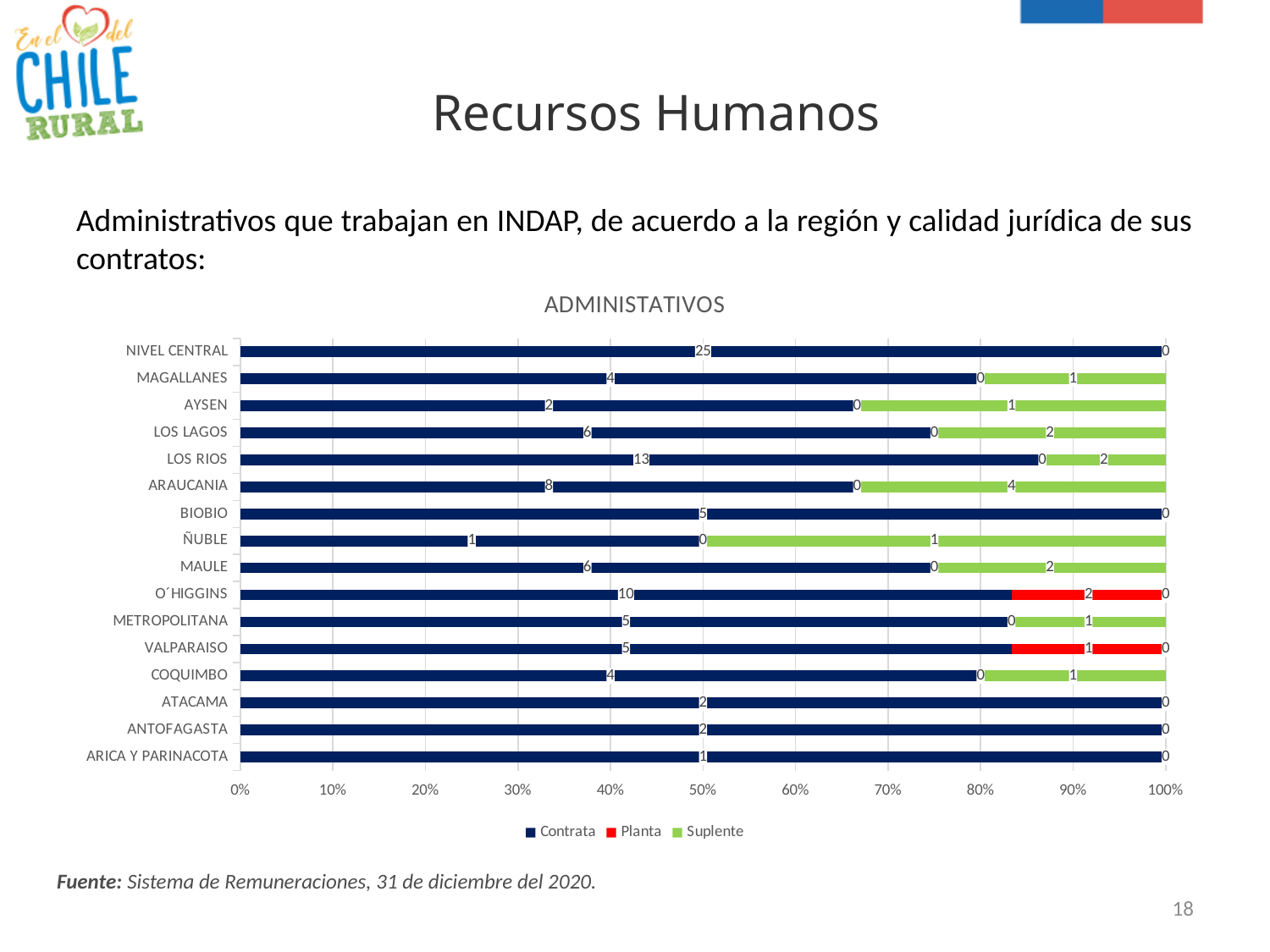
What is the Contrata value for LOS RIOS? 13 Which region has the highest Contrata value? NIVEL CENTRAL What is the total of the three series for O´HIGGINS? 12 What colour represents the Planta series in the legend? Red What is the Suplente value for ARAUCANIA? 4 How many regions (categories) are shown on the chart? 16 What is the Contrata value for NIVEL CENTRAL? 25 Which has the larger Contrata value, MAULE or COQUIMBO? MAULE What is the difference between the Contrata values for LOS RIOS and ARAUCANIA? 5 What is the Planta value for O´HIGGINS? 2 What kind of chart is shown? Stacked bar chart How many series does the legend list? 3